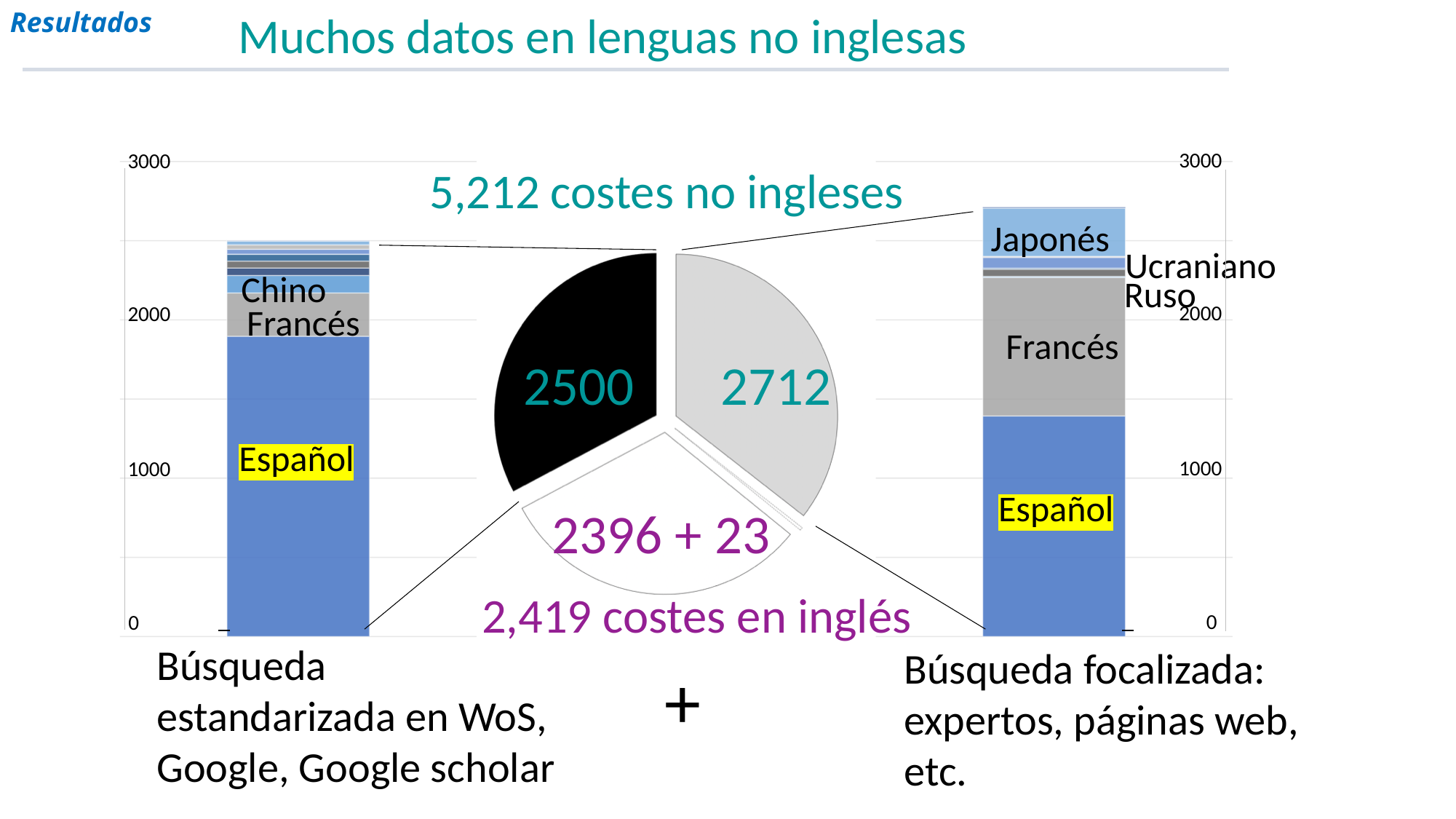
Which is larger: the Español segment in the left bar chart or the Español segment in the right bar chart? left bar chart What kind of chart is on the left side of the slide? bar chart In the centre pie chart, what value is printed on the black slice? 2500 In the right bar chart, is the total height of the stacked bar greater or less than 2000? greater In the centre pie chart, which slice has the largest value? 2712 In the left bar chart, is the value for Español greater or less than 1000? greater In the centre pie chart, what is the difference between the 2712 slice and the 2500 slice? 212 What kind of chart is in the centre of the slide? pie chart In the centre pie chart, what value is printed on the light grey slice? 2712 In the centre pie chart, what is the total of the 2500 and 2712 slices? 5,212 In the right bar chart, which language segment is the largest? Español